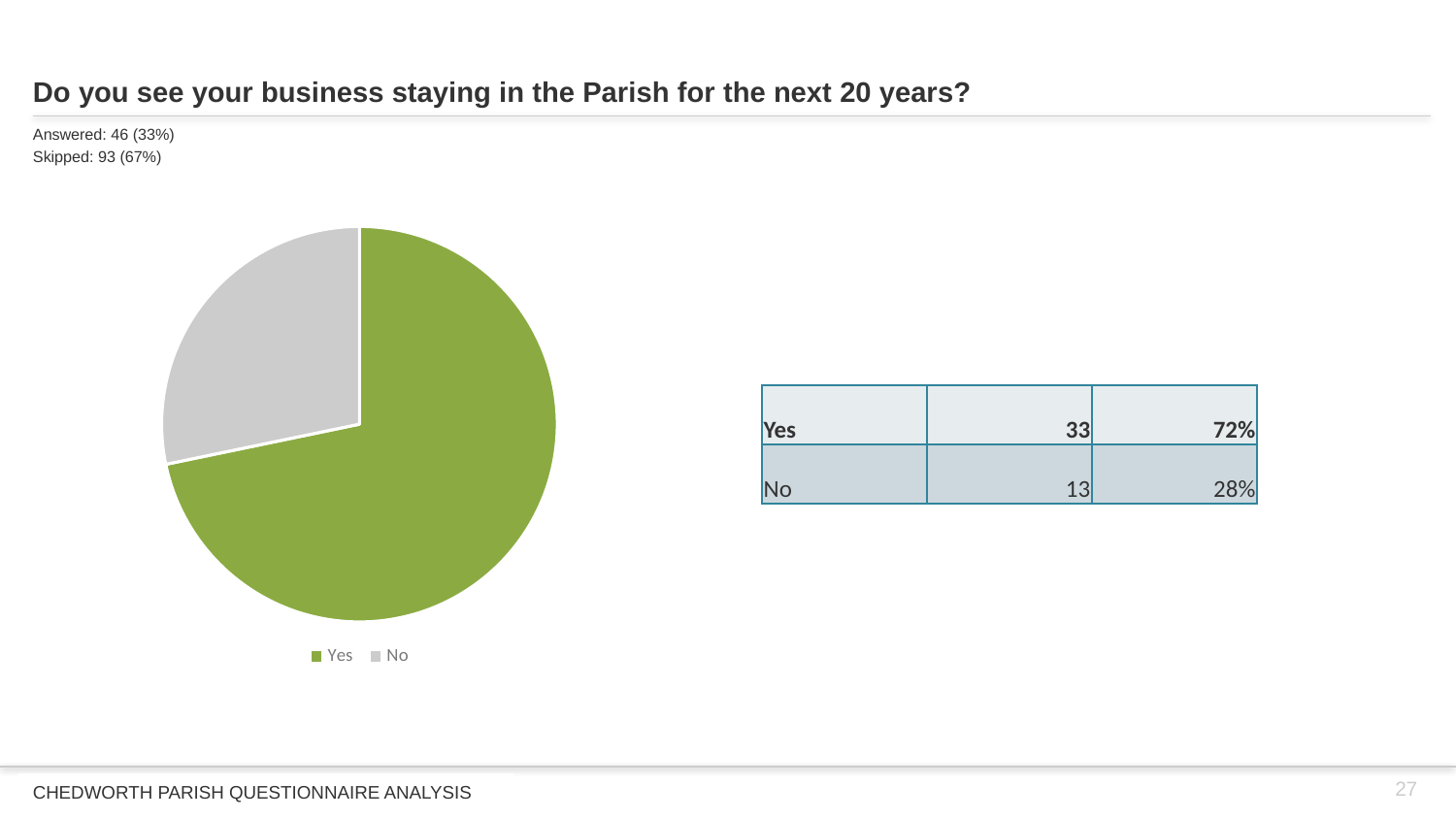
Which response has the smallest slice of the pie chart? No Which response has the largest slice of the pie chart? Yes What colour is the Yes slice in the pie chart? green How many slices does the pie chart have? 2 According to the table, how many respondents answered Yes? 33 What kind of chart is shown on the slide? pie chart What share of the pie does the Yes slice represent? 72% Which is larger, the Yes slice or the No slice? Yes What share of the pie does the No slice represent? 28% How many entries does the legend of the pie chart list? 2 What is the difference between the number of Yes and No responses? 20 According to the table, how many respondents answered No? 13